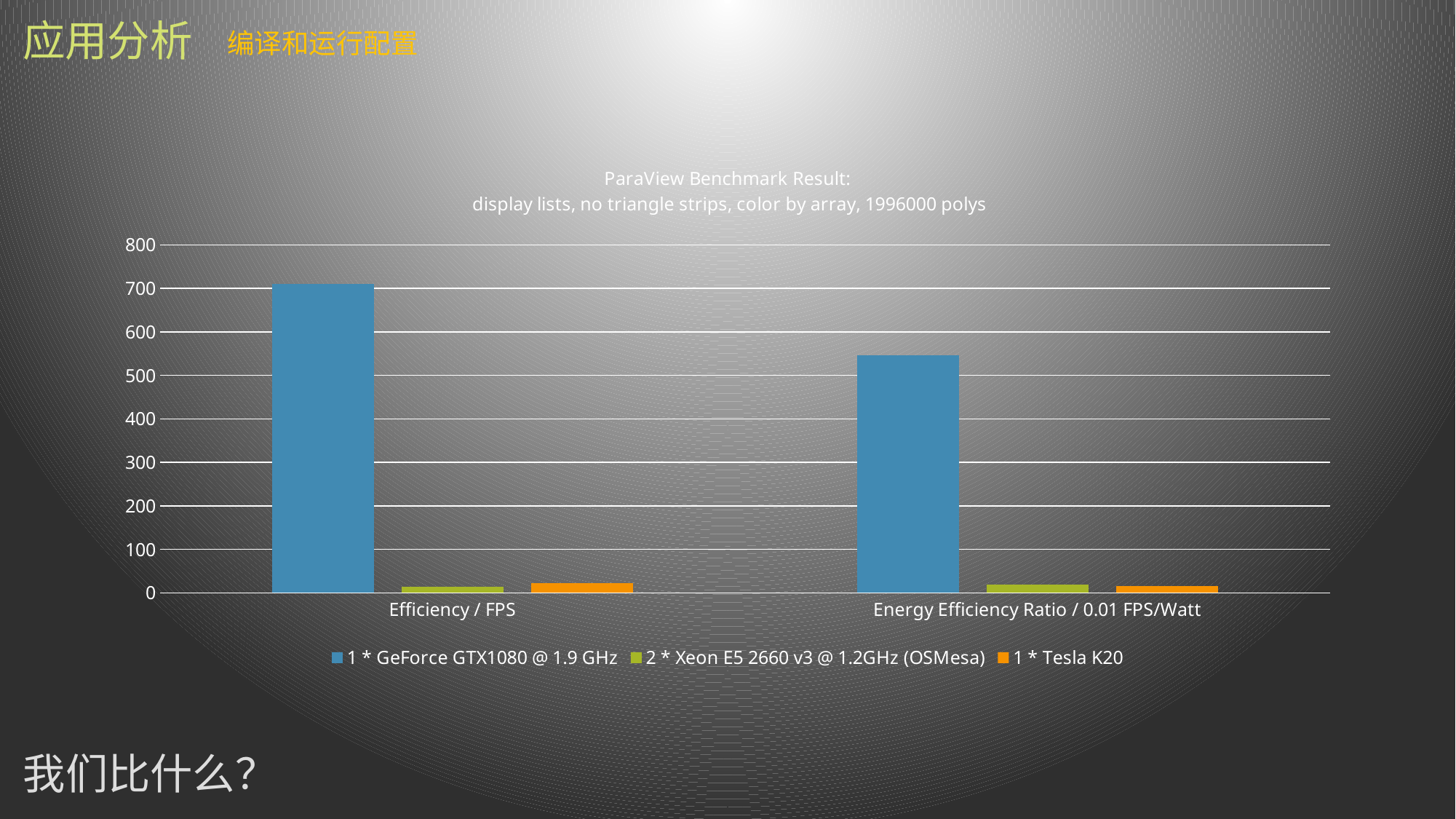
How many categories are shown on the x axis? 2 What colour are the bars for 1 * Tesla K20? orange Is the Energy Efficiency Ratio value for 1 * GeForce GTX1080 @ 1.9 GHz greater or less than 500? greater Is the Efficiency / FPS value for 1 * Tesla K20 greater or less than 100? less For 1 * GeForce GTX1080 @ 1.9 GHz, which is larger: the Efficiency / FPS value or the Energy Efficiency Ratio value? Efficiency / FPS Which series has the highest value for Efficiency / FPS? 1 * GeForce GTX1080 @ 1.9 GHz Which is larger for Efficiency / FPS: 1 * GeForce GTX1080 @ 1.9 GHz or 2 * Xeon E5 2660 v3 @ 1.2GHz (OSMesa)? 1 * GeForce GTX1080 @ 1.9 GHz Which series has the highest value for Energy Efficiency Ratio / 0.01 FPS/Watt? 1 * GeForce GTX1080 @ 1.9 GHz Is the Energy Efficiency Ratio value for 1 * GeForce GTX1080 @ 1.9 GHz greater or less than 600? less What kind of chart is shown on the slide? bar chart How many series does the legend list? 3